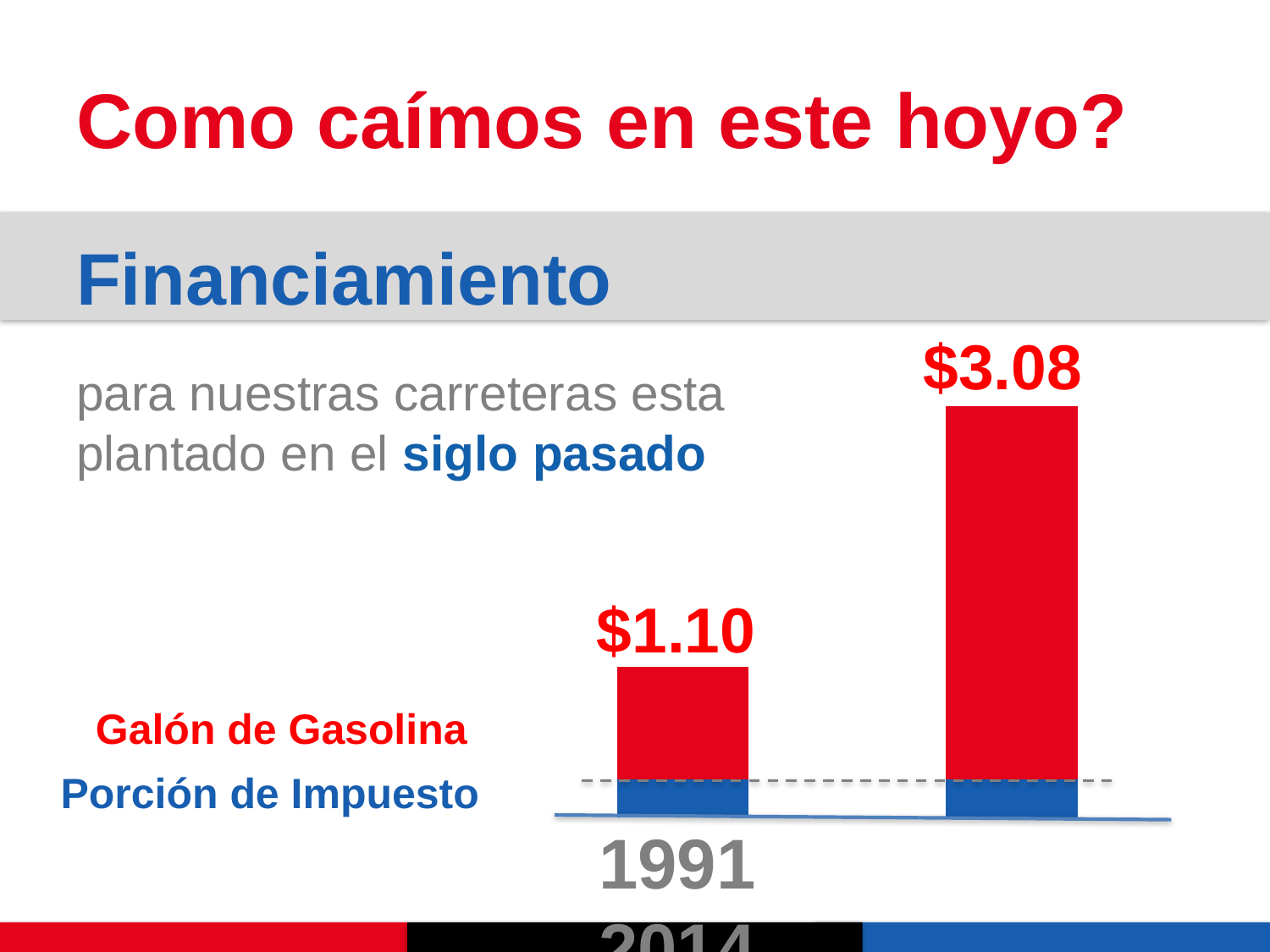
Which bar is the lowest? the 1991 bar What colour is the 'Porción de Impuesto' segment of the bars? blue How many series (segments) does each bar contain according to the labels on the slide? 2 Which is larger, the value for 1991 or the value for the right-hand bar? the right-hand bar ($3.08) How many bars are plotted in the chart? 2 What does the red portion of the bars represent? Galón de Gasolina Do the bar values rise or fall from the left bar to the right bar? rise What kind of chart is shown on the slide? bar chart What is the difference between the $3.08 bar and the $1.10 bar? $1.98 What is the value shown for the right-hand (taller) bar? $3.08 Which bar is the highest, the left (1991) bar or the right bar? the right bar What is the value shown for the 1991 bar? $1.10